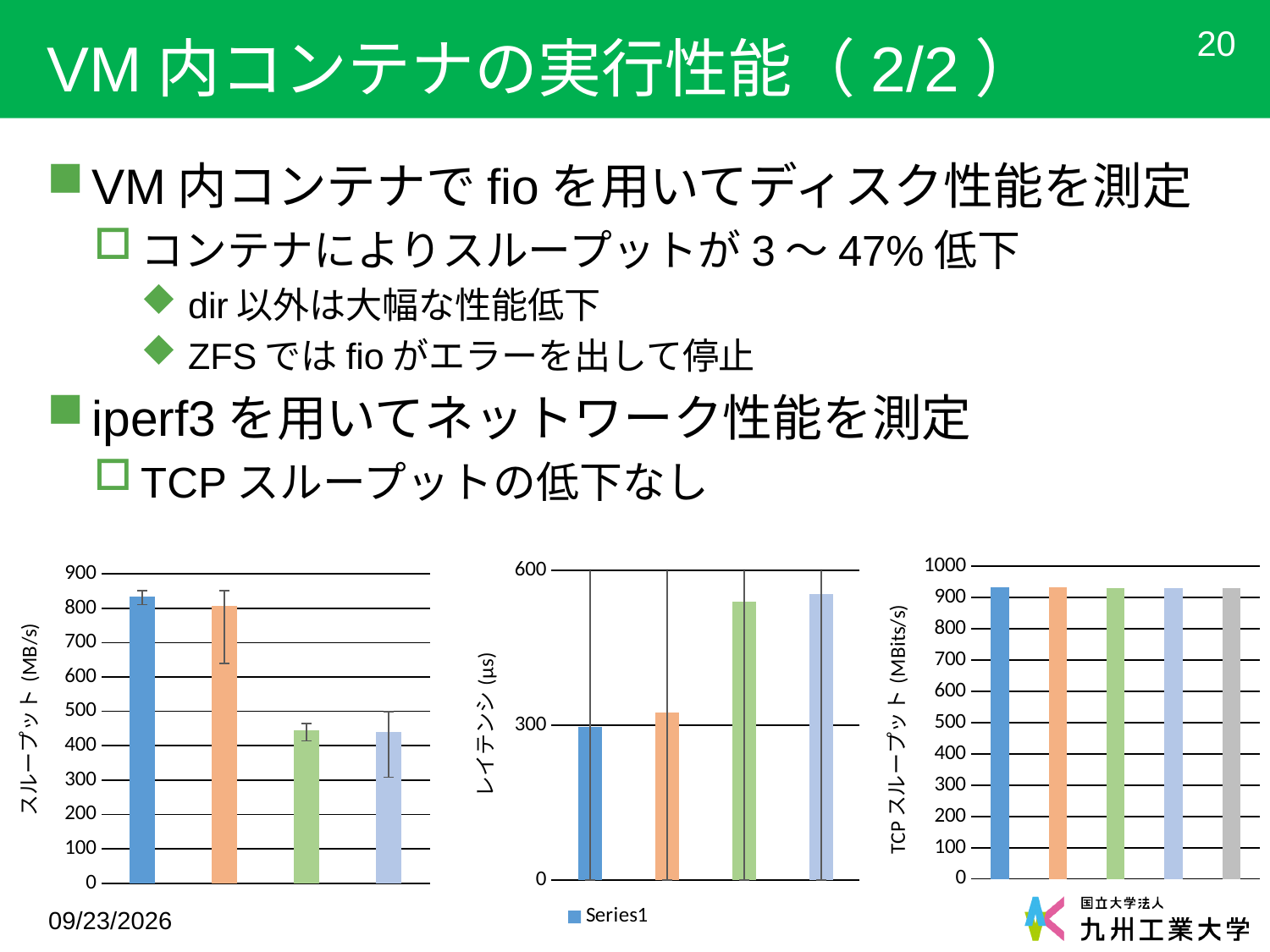
In the left chart (スループット (MB/s)), is the value of the first (blue) bar greater or less than 800? greater In the left chart (スループット (MB/s)), which bar is the highest? the first (blue) bar How many bars are plotted in the right chart (TCP スループット (MBits/s))? 5 How many series does the legend of the middle chart (レイテンシ (µs)) list? 1 In the middle chart (レイテンシ (µs)), which bar is the lowest? the first (blue) bar In the middle chart (レイテンシ (µs)), is the fourth (light blue) bar larger or smaller than the second (orange) bar? larger What is the y-axis title of the middle chart? レイテンシ (µs) In the left chart (スループット (MB/s)), is the value of the third (green) bar greater or less than 500? less What kind of chart is the left chart on the slide? bar chart In the right chart (TCP スループット (MBits/s)), is the value of the first (blue) bar greater or less than 900? greater How many bars are plotted in the left chart (スループット (MB/s))? 4